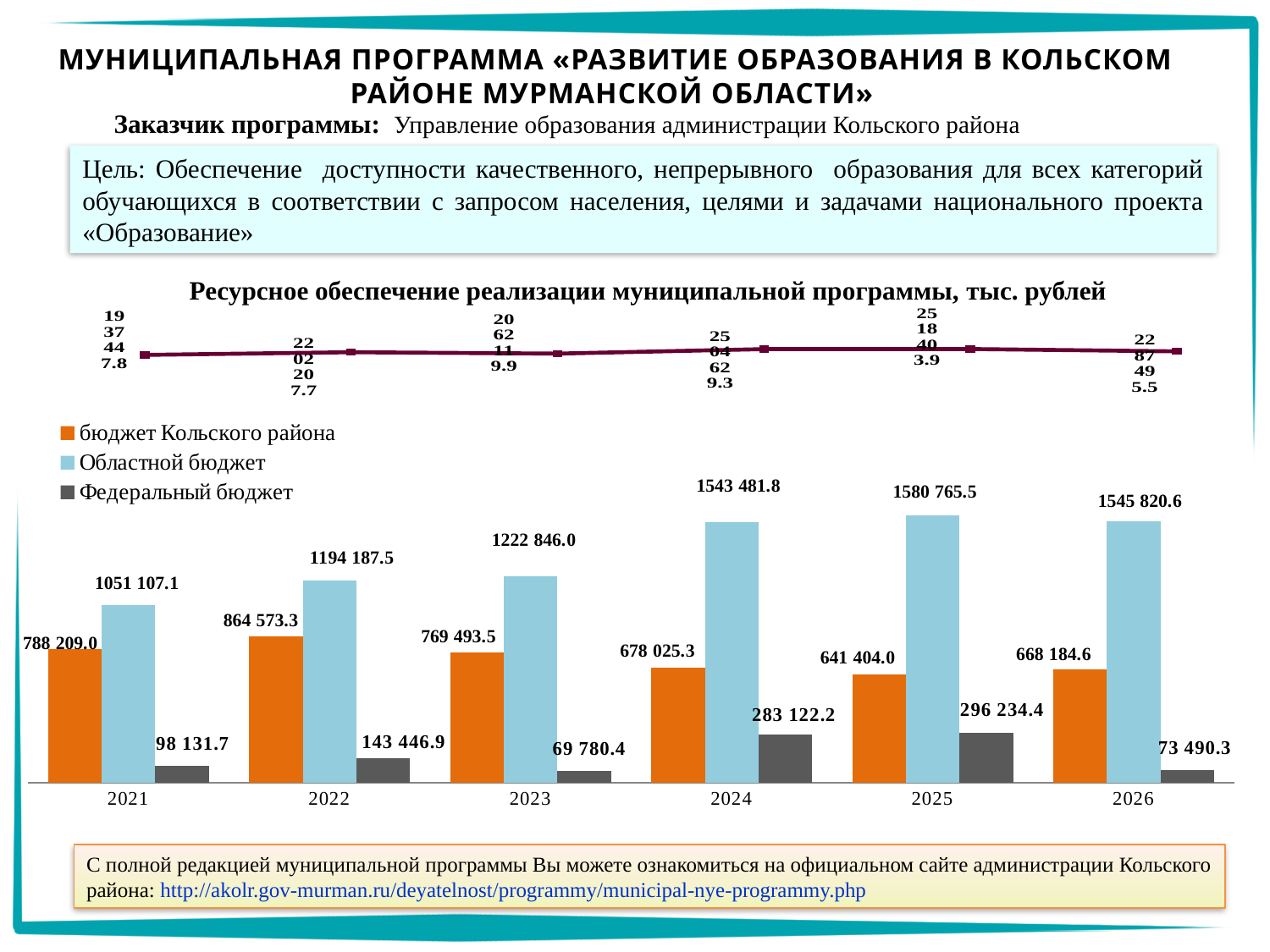
How many series does the legend list? 3 What is the value of Областной бюджет for 2024? 1543 481.8 In which year is Федеральный бюджет the lowest? 2023 How many years are shown on the x axis of the chart? 6 In which year is бюджет Кольского района the highest? 2022 What is the difference between Областной бюджет in 2025 and in 2024? 37 283.7 What is the value of Федеральный бюджет for 2022? 143 446.9 What kind of chart is used to show the budget values by year? bar chart What is the value of бюджет Кольского района for 2026? 668 184.6 In which year is Областной бюджет the highest? 2025 Does бюджет Кольского района rise or fall from 2022 to 2025? fall Which year has the larger Федеральный бюджет, 2024 or 2025? 2025